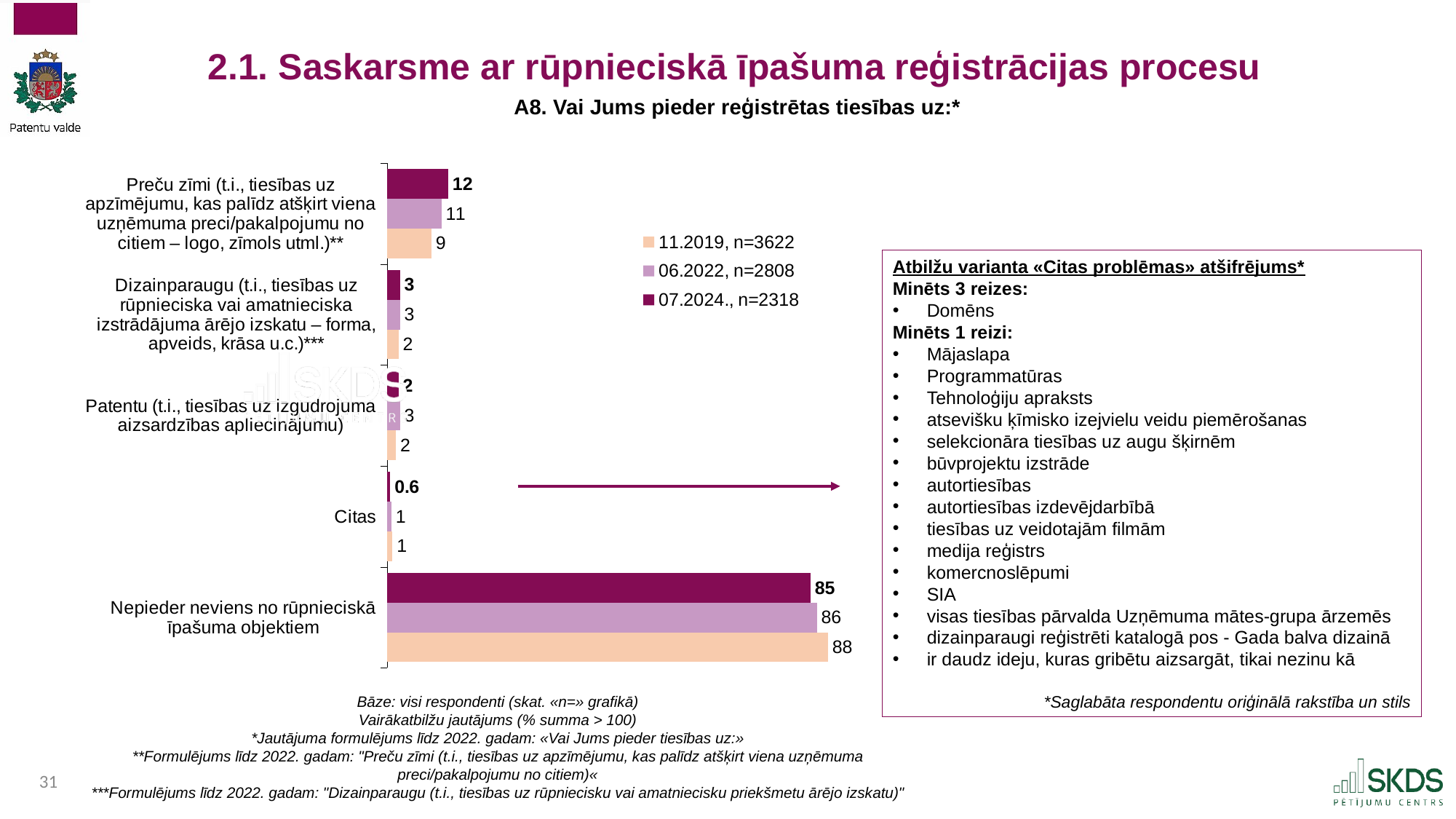
What is the sample size (n) shown in the legend for the 07.2024 series? n=2318 What is the value for 'Citas' in the 07.2024 series? 0.6 For 'Preču zīmi', which series has the larger value: 07.2024 or 11.2019? 07.2024 How many categories are shown on the chart? 5 What is the difference between the 11.2019 and 07.2024 values for 'Nepieder neviens no rūpnieciskā īpašuma objektiem'? 3 What kind of chart is shown on the slide? bar chart What is the value for 'Preču zīmi' in the 07.2024 series? 12 What is the value for 'Patentu' in the 06.2022 series? 3 Which category has the highest value in the 07.2024 series? Nepieder neviens no rūpnieciskā īpašuma objektiem How many series does the chart legend list? 3 What is the value for 'Nepieder neviens no rūpnieciskā īpašuma objektiem' in the 06.2022 series? 86 What is the value for 'Preču zīmi' in the 11.2019 series? 9